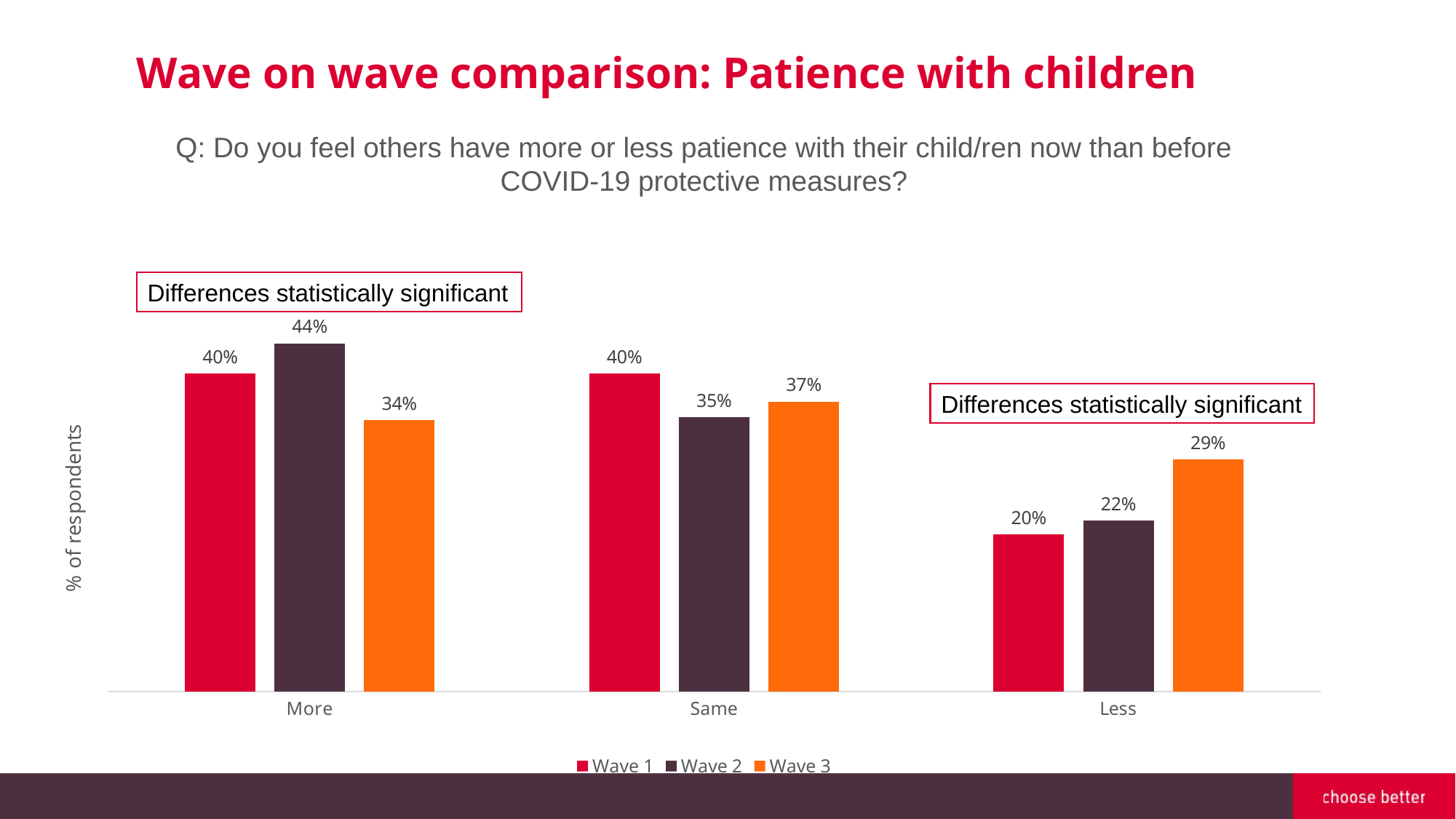
What is the difference between the Wave 2 and Wave 3 values for the 'More' category? 10% What is the Wave 3 value for the 'Less' category? 29% Which category has the highest Wave 3 value? Same What kind of chart is shown on the slide? Bar chart Do the Wave 3 values rise or fall from 'More' to 'Same'? Rise What is the Wave 2 value for the 'More' category? 44% Which category has the lowest Wave 1 value? Less What is the Wave 1 value for the 'Same' category? 40% How many series does the legend list? 3 How many categories are shown on the x axis? 3 Which is larger for the 'Same' category: the Wave 2 value or the Wave 3 value? Wave 3 What is the difference between the Wave 3 and Wave 1 values for the 'Less' category? 9%